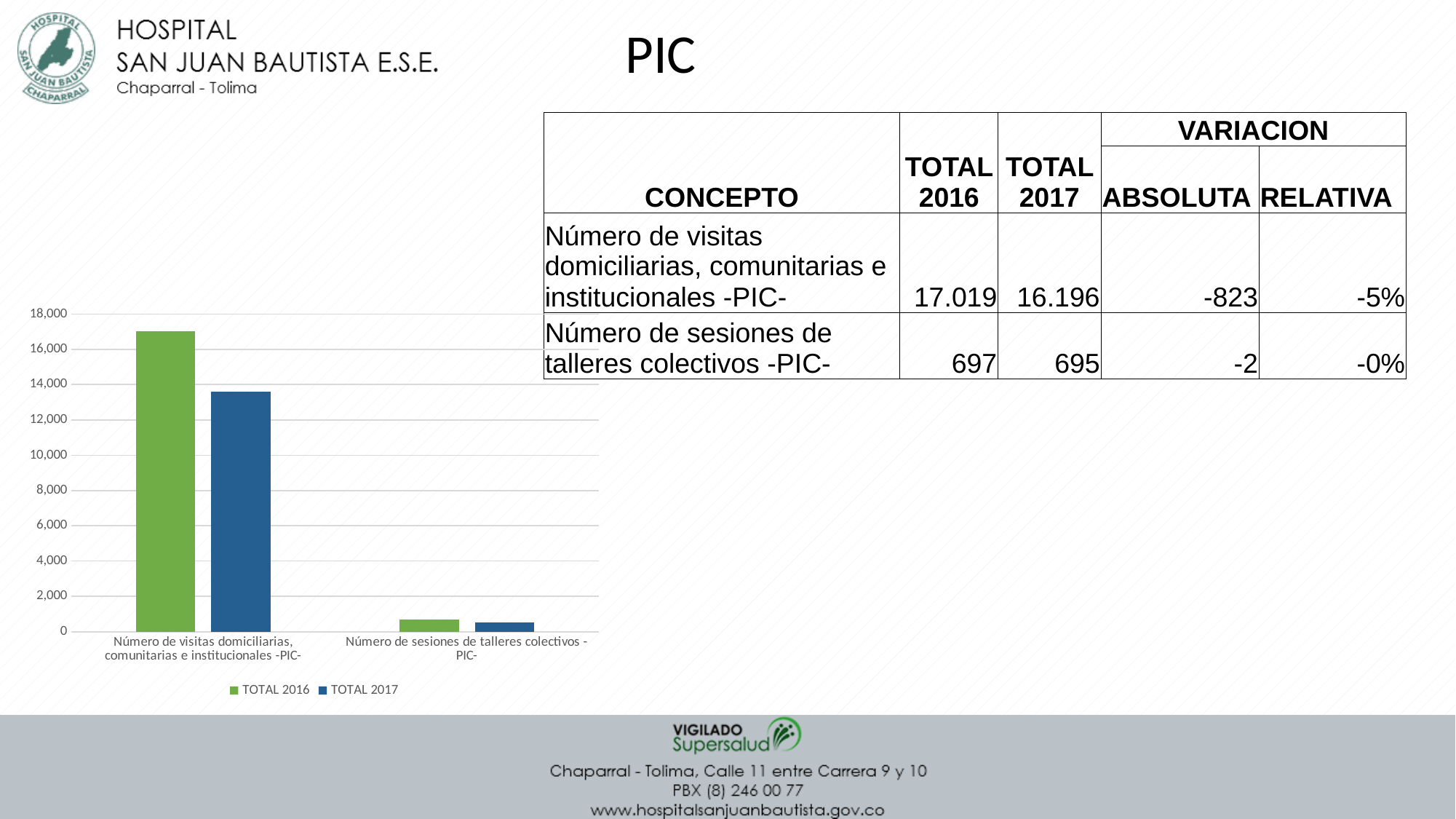
How many categories are shown on the x axis of the chart? 2 What kind of chart is shown on the slide? bar chart Is the TOTAL 2017 value for 'Número de visitas domiciliarias, comunitarias e institucionales -PIC-' greater or less than 14,000? less Is the TOTAL 2016 value for 'Número de visitas domiciliarias, comunitarias e institucionales -PIC-' greater or less than 16,000? greater Is the TOTAL 2017 value for 'Número de visitas domiciliarias, comunitarias e institucionales -PIC-' greater or less than 12,000? greater Which series does the blue bar represent in the chart? TOTAL 2017 Which series does the green bar represent in the chart? TOTAL 2016 How many series does the chart legend list? 2 Which category has the lowest TOTAL 2017 bar in the chart? Número de sesiones de talleres colectivos -PIC- For 'Número de visitas domiciliarias, comunitarias e institucionales -PIC-', which is larger in the chart, TOTAL 2016 or TOTAL 2017? TOTAL 2016 Which category has the highest TOTAL 2016 bar in the chart? Número de visitas domiciliarias, comunitarias e institucionales -PIC-